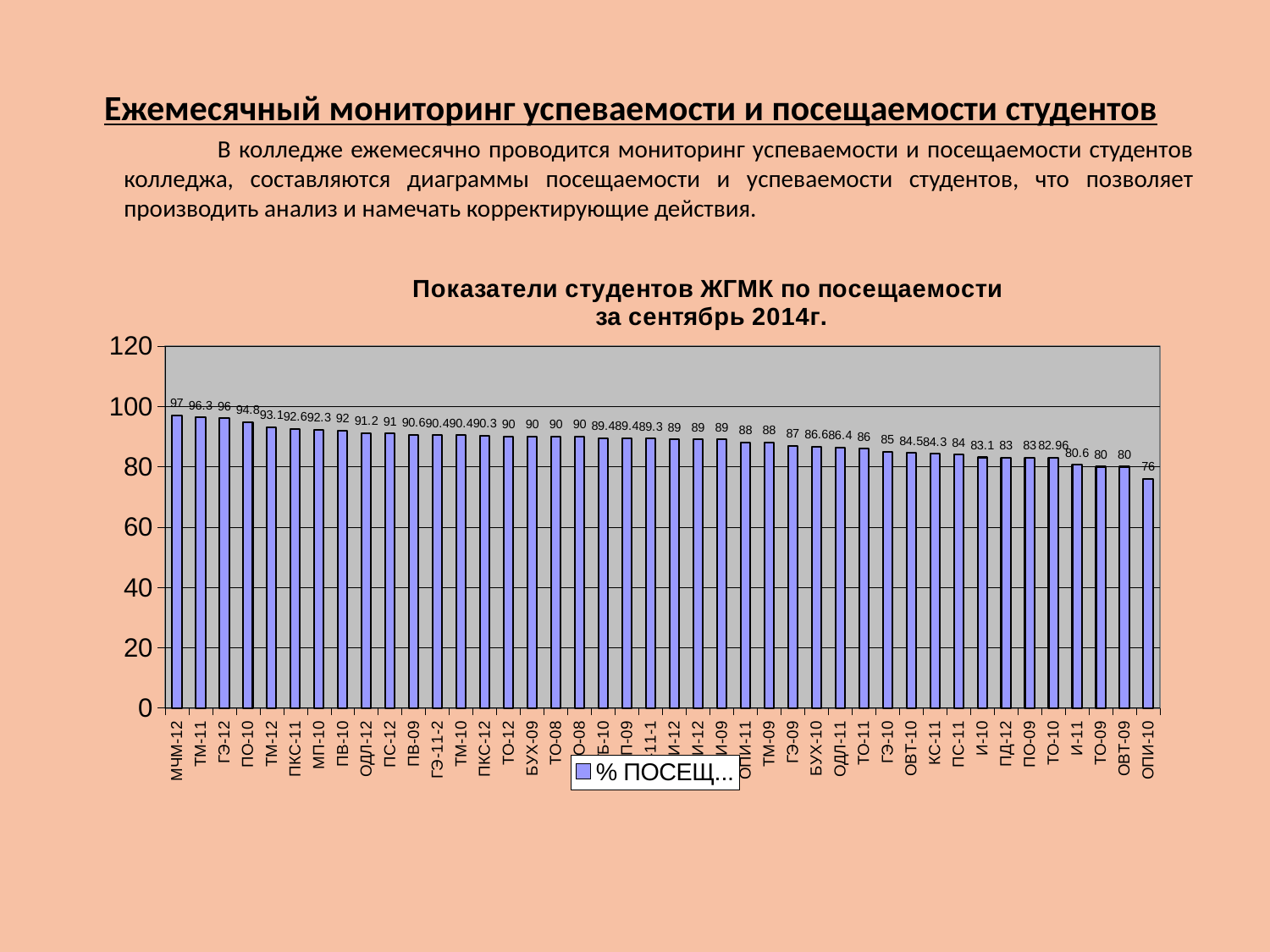
What is the value for И-11? 80.6 What is the difference between the values for МЧМ-12 and ОПИ-10? 21 What is the value for ПО-10? 94.8 Do the values rise or fall from left to right along the x axis? fall What kind of chart is shown on the slide? bar chart Which is larger, the value for ПО-10 or the value for ТМ-12? ПО-10 Which group has the lowest attendance value? ОПИ-10 What is the value for ОПИ-10? 76 Which group has the highest attendance value? МЧМ-12 How many series does the legend list? 1 What is the title of the chart? Показатели студентов ЖГМК по посещаемости за сентябрь 2014г. What is the value for ГЭ-09? 87